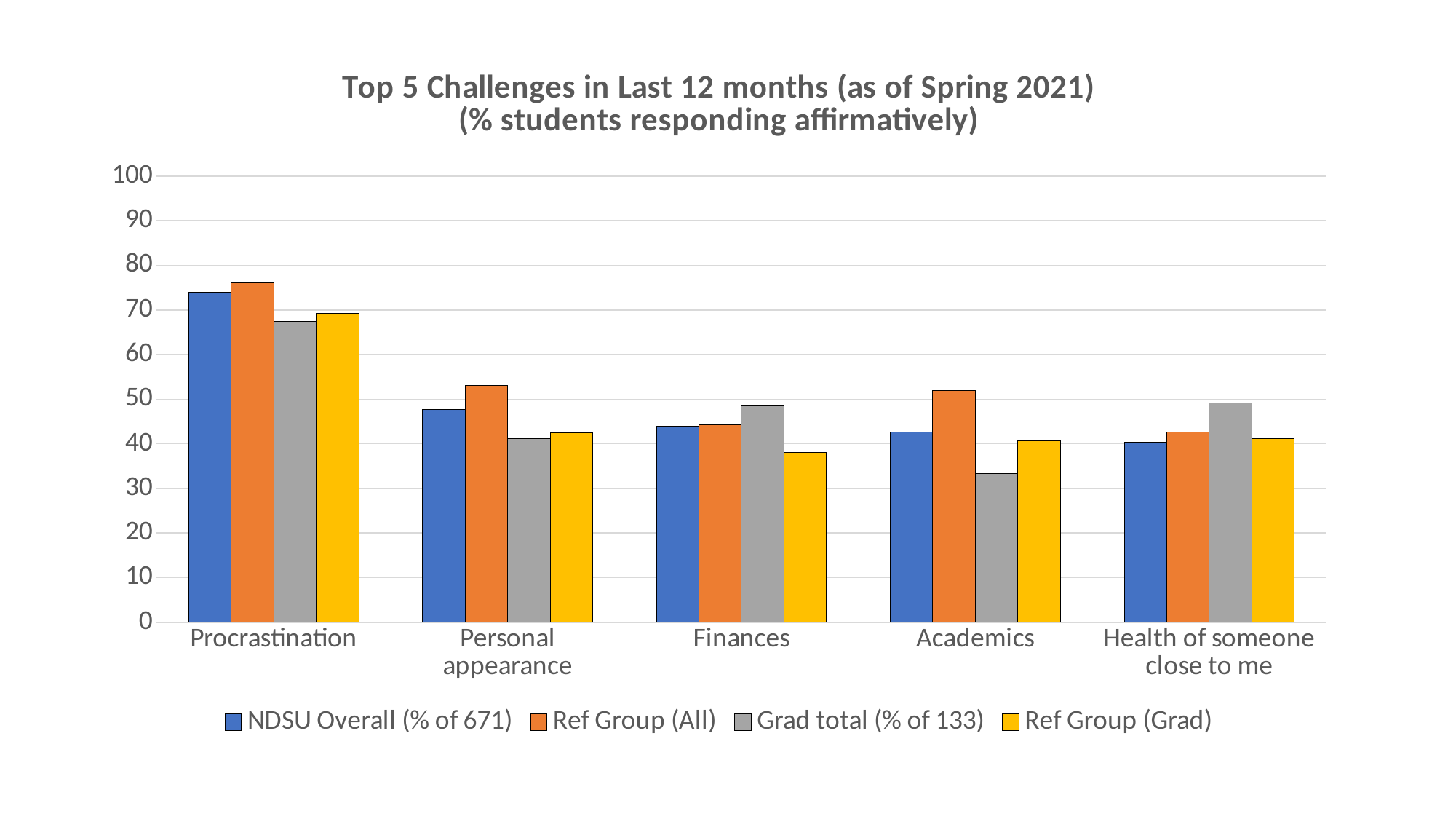
Is the Grad total (% of 133) value for Academics greater or less than 40? less What is the title of the chart? Top 5 Challenges in Last 12 months (as of Spring 2021) (% students responding affirmatively) For Personal appearance, which is larger: Ref Group (All) or Grad total (% of 133)? Ref Group (All) For Finances, which is larger: Grad total (% of 133) or Ref Group (Grad)? Grad total (% of 133) Is the Grad total (% of 133) value for Health of someone close to me greater or less than 45? greater What kind of chart is shown on the slide? bar chart How many challenge categories are shown on the x axis? 5 How many series does the legend list? 4 What colour represents the Ref Group (Grad) series? yellow Is the Ref Group (All) value for Procrastination greater or less than 70? greater For the NDSU Overall (% of 671) series, which category has the highest value? Procrastination For the Grad total (% of 133) series, which category has the lowest value? Academics